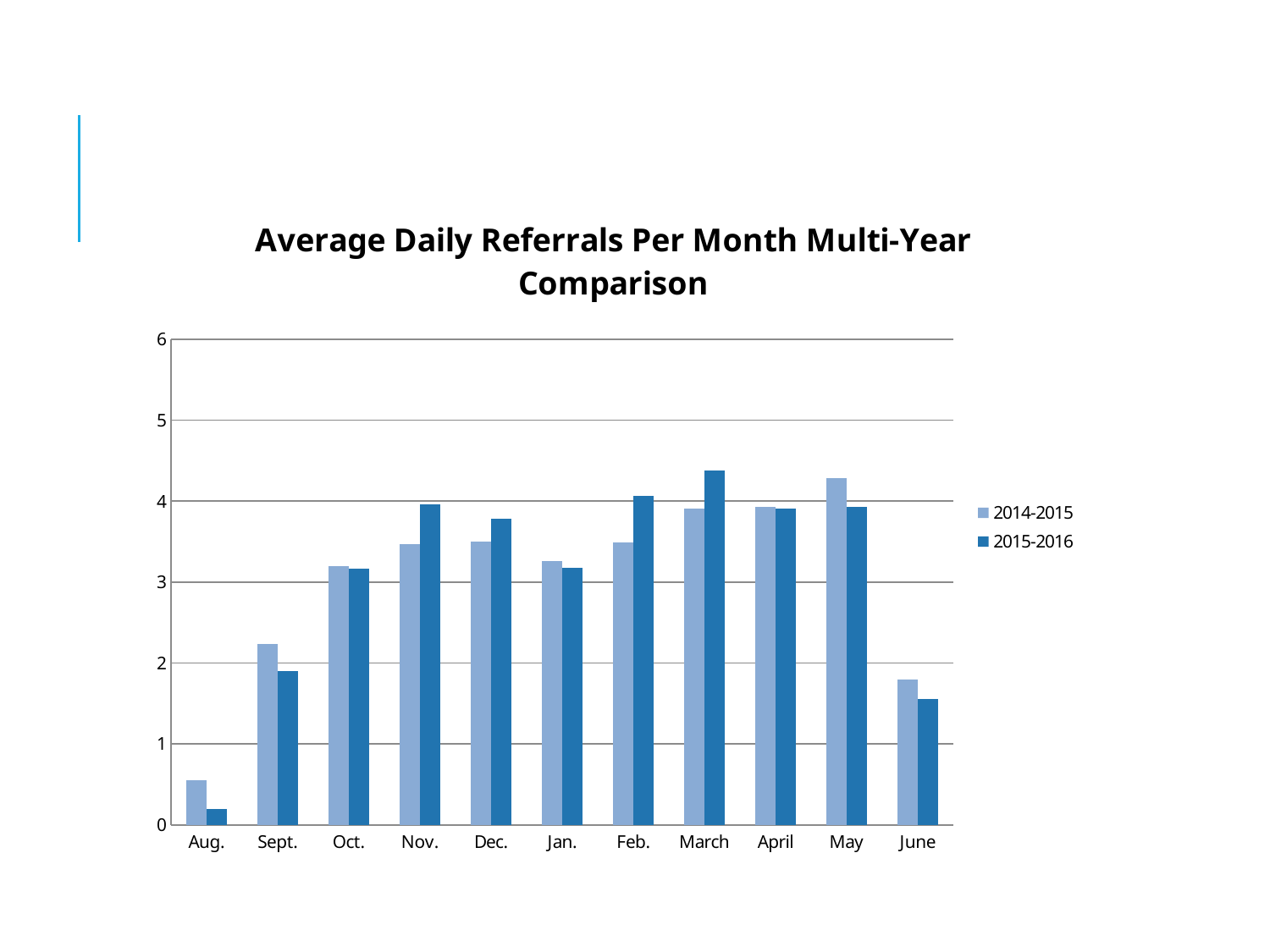
How many months are shown on the x axis? 11 In Nov., which series has the larger value, 2014-2015 or 2015-2016? 2015-2016 What type of chart is shown on the slide? bar chart Which month has the lowest value for the 2015-2016 series? Aug. Is the value for Aug. in the 2014-2015 series greater or less than 1? less Is the value for June in the 2015-2016 series greater or less than 2? less Which month has the highest value for the 2015-2016 series? March Which month has the highest value for the 2014-2015 series? May How many series does the legend list? 2 In Sept., which series has the larger value, 2014-2015 or 2015-2016? 2014-2015 What is the title of the chart? Average Daily Referrals Per Month Multi-Year Comparison Is the value for March in the 2015-2016 series greater or less than 4? greater